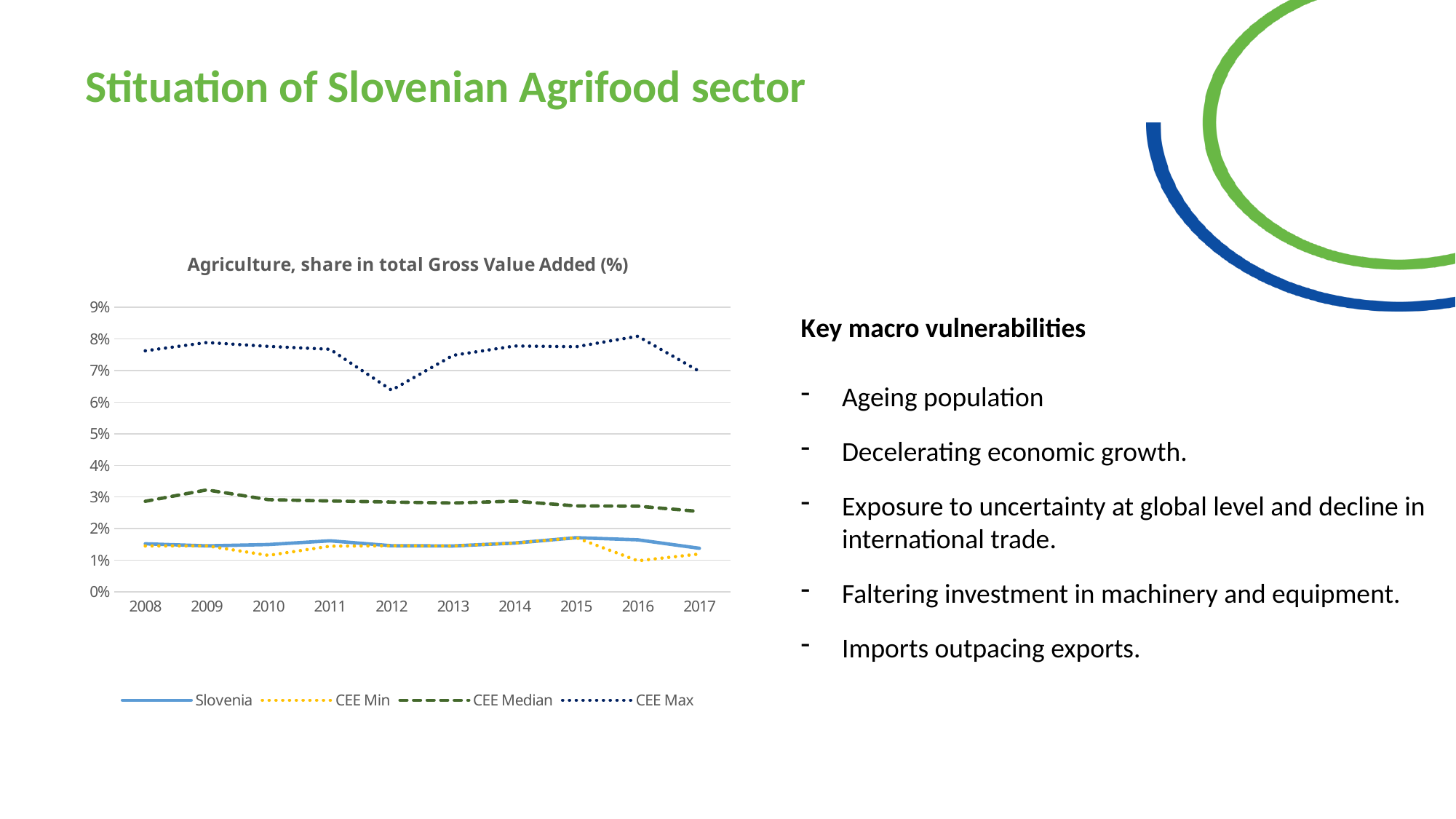
What is the title of the chart? Agriculture, share in total Gross Value Added (%) Is the value for CEE Median in 2009 greater or less than 3%? greater In 2008, which is larger: the value for CEE Max or the value for CEE Median? CEE Max In which year does the CEE Min series reach its lowest value? 2016 Is the value for CEE Max in 2012 greater or less than 7%? less Is the value for CEE Max in 2016 greater or less than 7%? greater In which year does the CEE Max series reach its lowest value? 2012 How many series does the legend of the chart list? 4 Does the CEE Median series rise or fall from 2009 to 2017? fall What kind of chart is shown on the slide? line chart How many years are shown on the x axis of the chart? 10